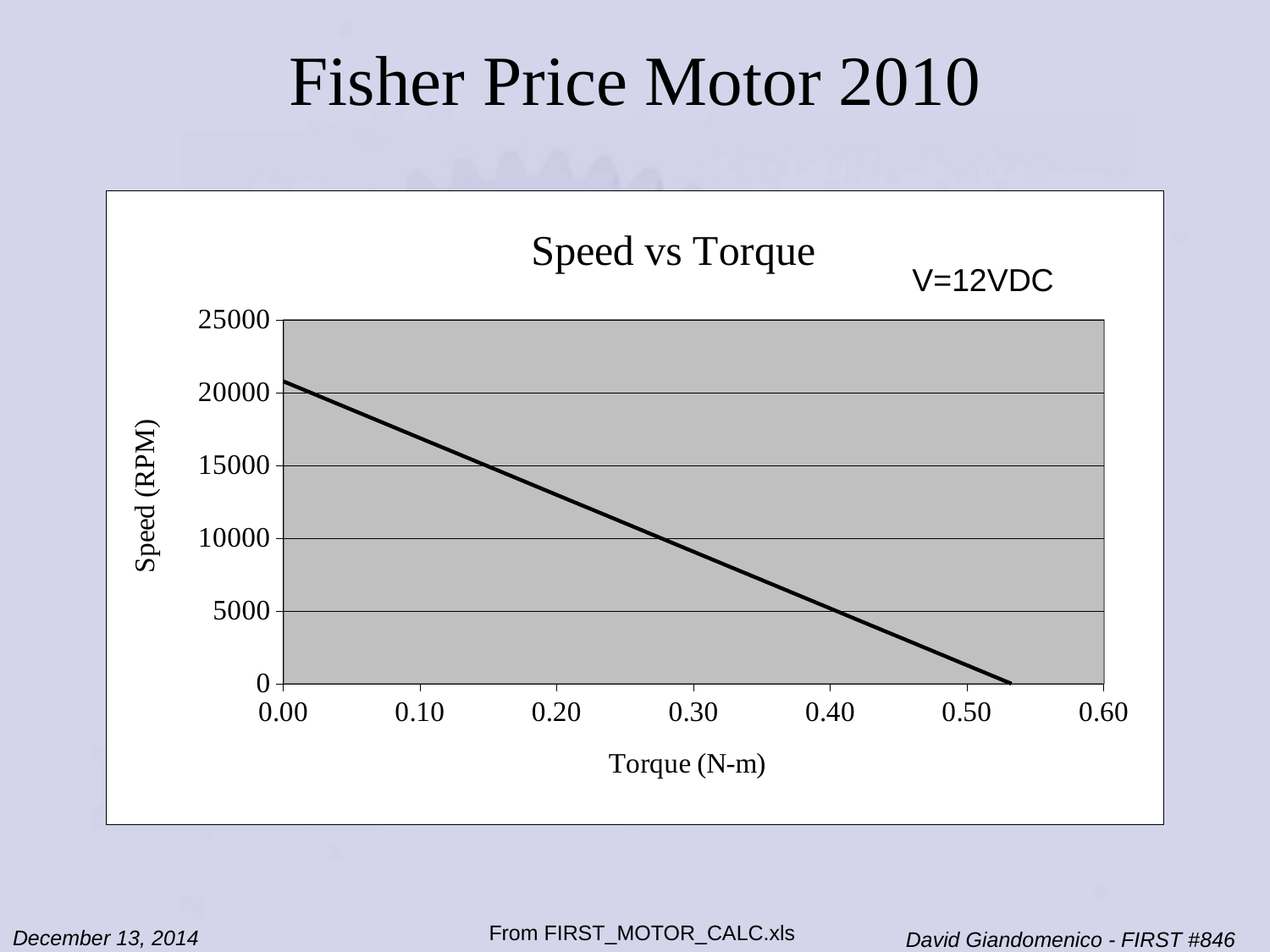
Does speed rise or fall as torque increases along the x axis? fall Is the speed at a torque of 0.20 N-m greater or less than 10000 RPM? greater Is the speed higher at a torque of 0.10 N-m or at 0.40 N-m? 0.10 N-m What kind of chart is shown on the slide? line chart Is the speed at a torque of 0.40 N-m greater or less than 10000 RPM? less Is the speed at a torque of 0.50 N-m greater or less than 5000 RPM? less What is the label of the y axis? Speed (RPM) What is the title of the chart? Speed vs Torque